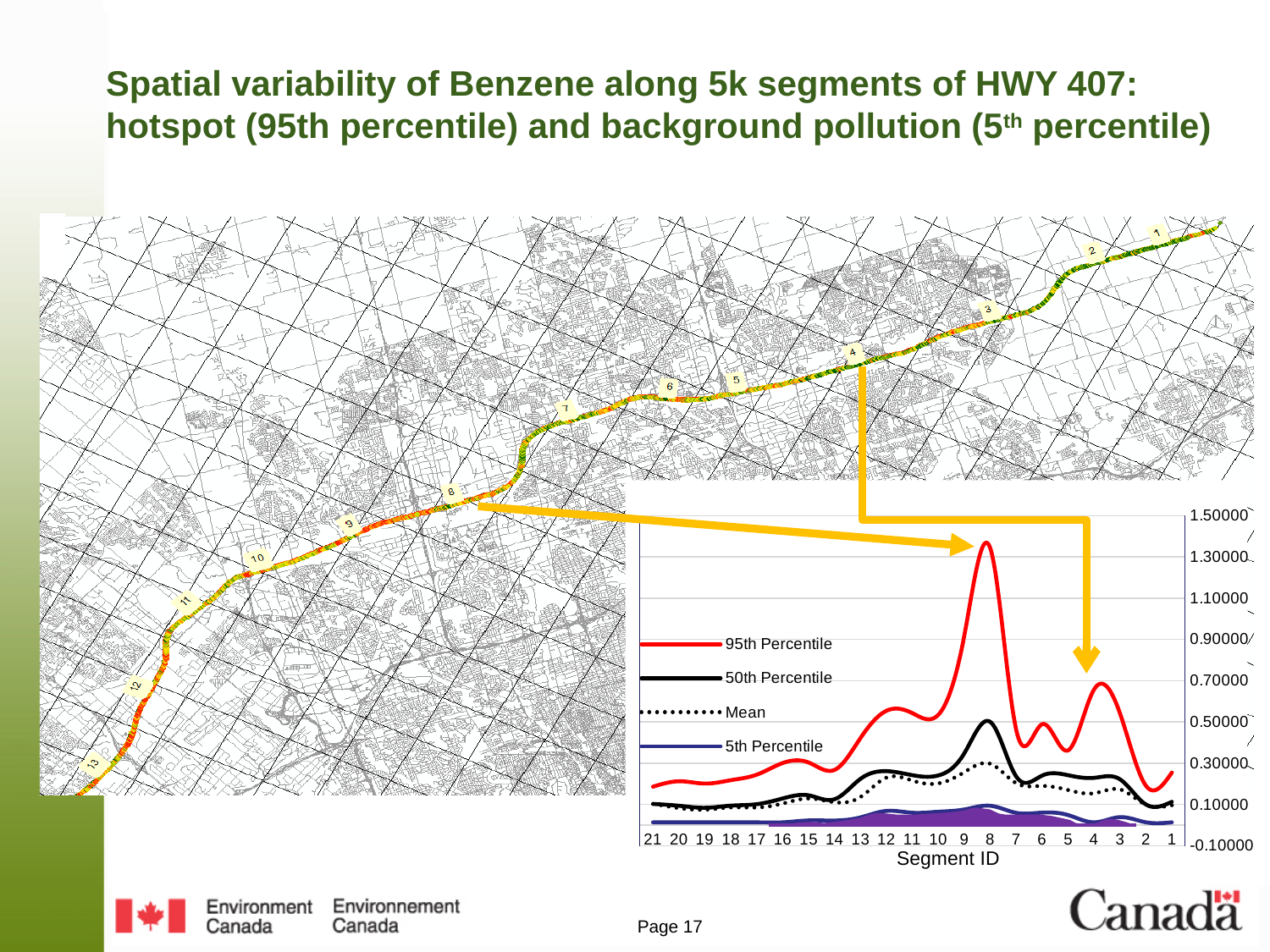
What is the title of the x axis of the chart? Segment ID What kind of chart is shown on the slide? line chart Which series has the lowest values across the chart? 5th Percentile Is the 95th Percentile value at segment 21 greater or less than 0.30000? less Is the 95th Percentile value at segment 4 greater or less than 0.50000? greater At which segment ID does the 95th Percentile series reach its highest value? 8 Which segment has the larger 95th Percentile value: segment 8 or segment 4? segment 8 How many segment IDs are shown along the x axis of the chart? 21 Which is larger at segment 8: the 95th Percentile or the 5th Percentile? 95th Percentile How many series does the chart legend list? 4 Is the 95th Percentile value at segment 8 greater or less than 1.10000? greater